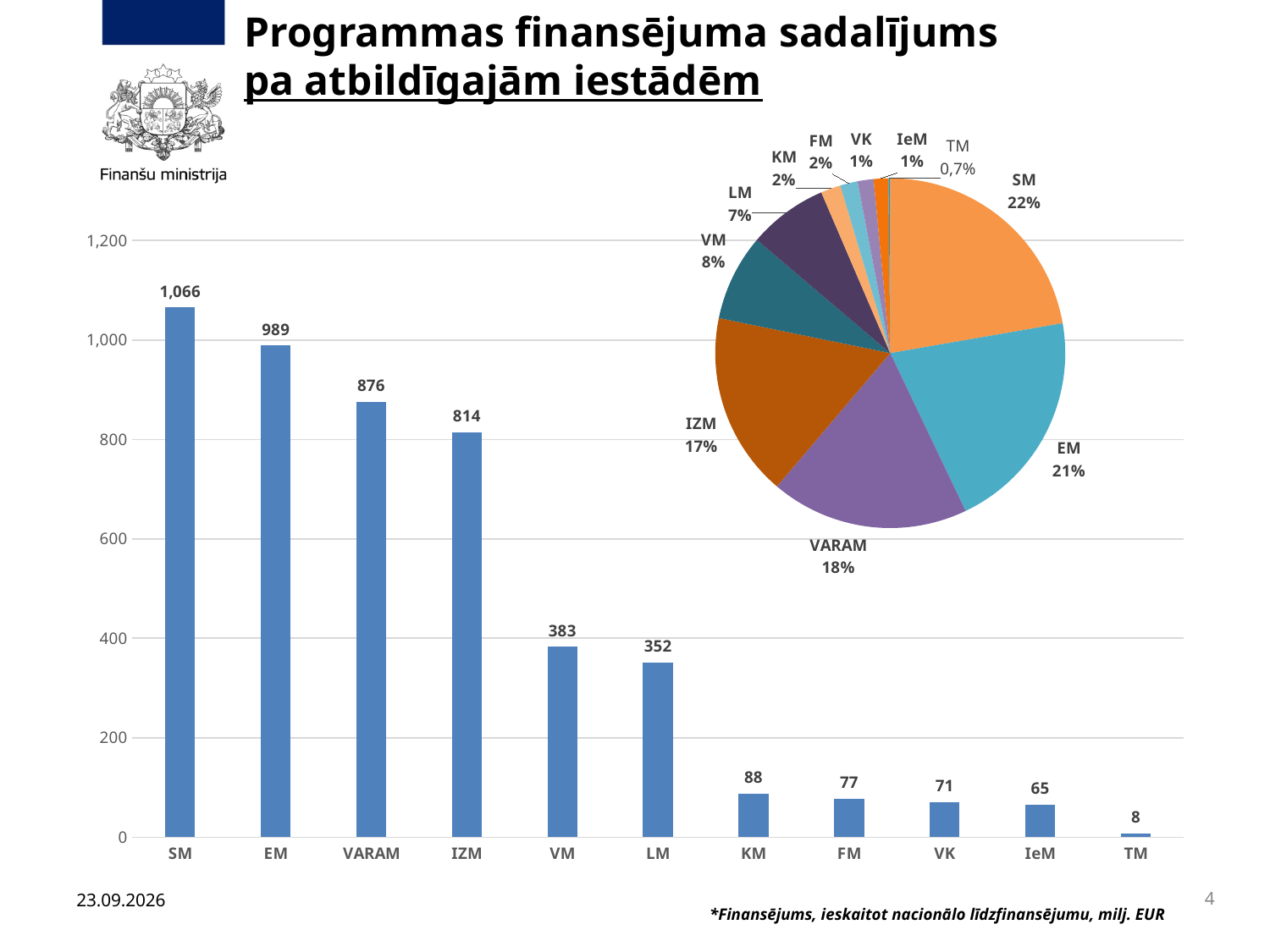
In the bar chart on the left, do the values rise or fall from left to right along the x axis? Fall In the bar chart on the left, which category has the lowest value? TM In the bar chart on the left, what is the value for VARAM? 876 In the bar chart on the left, what is the difference between the values for SM and EM? 77 In the pie chart on the right, what share does EM have? 21% In the bar chart on the left, how many categories are shown on the x axis? 11 What kind of chart is the chart on the left of the slide? Bar chart In the bar chart on the left, which is larger, the value for VM or the value for LM? VM In the pie chart on the right, which slice is the largest? SM In the bar chart on the left, which category has the highest value? SM In the bar chart on the left, what is the value for LM? 352 In the pie chart on the right, what share does TM have? 0,7%